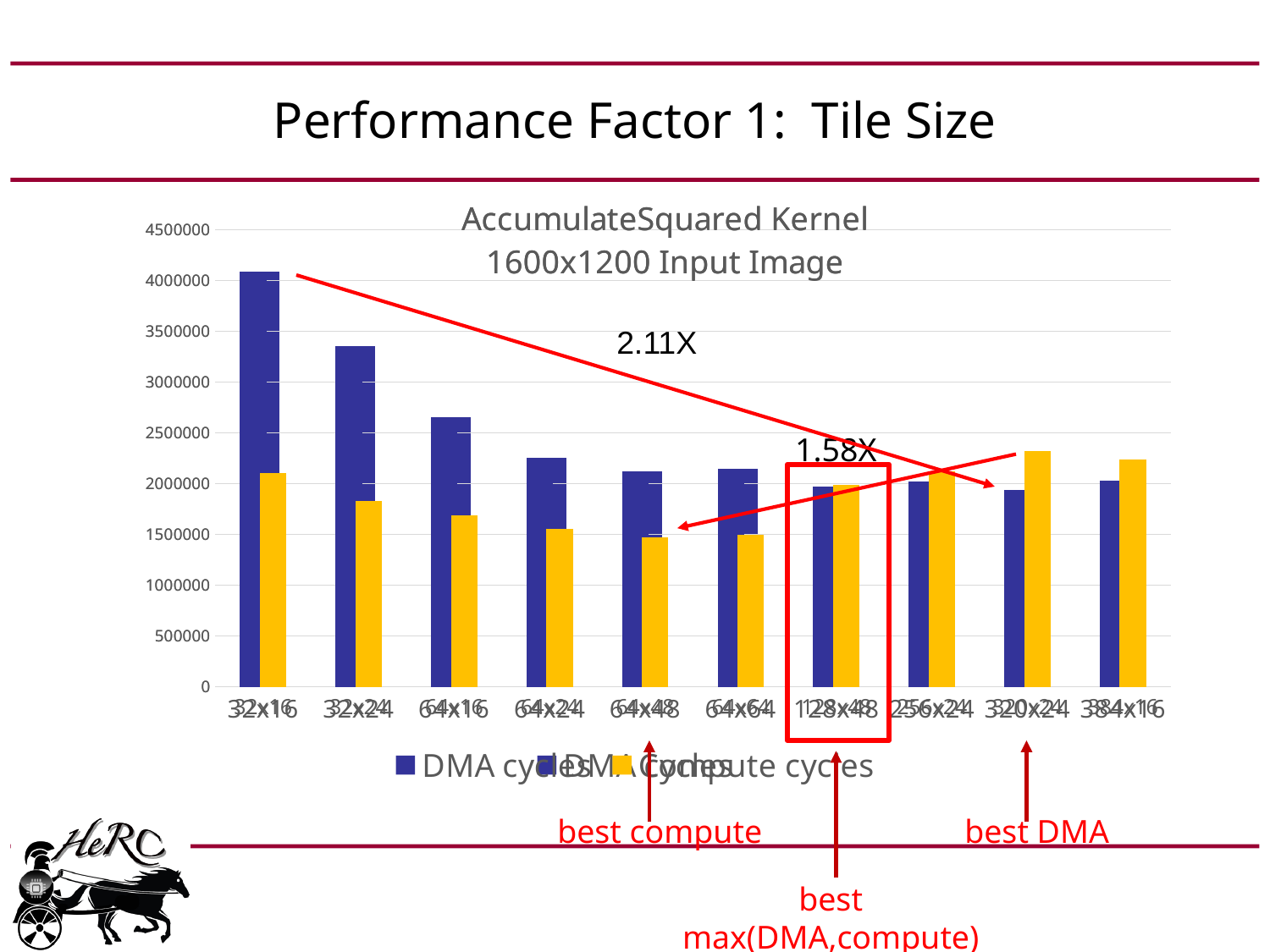
Which tile size has the highest DMA cycles? 32x16 What is the title of the chart? AccumulateSquared Kernel 1600x1200 Input Image Is the DMA cycles value for 32x16 greater or less than 3500000? greater How many series does the chart legend list? 2 What kind of chart is shown on the slide? bar chart Is the Compute cycles value for 320x24 greater or less than 2000000? greater Which is larger for the 32x16 tile size, DMA cycles or Compute cycles? DMA cycles How many tile-size categories are plotted on the x axis? 10 Is the DMA cycles value for 32x24 greater or less than 3000000? greater Do the DMA cycles rise or fall along the x axis from 32x16 to 64x64? fall Which is larger for the 320x24 tile size, DMA cycles or Compute cycles? Compute cycles